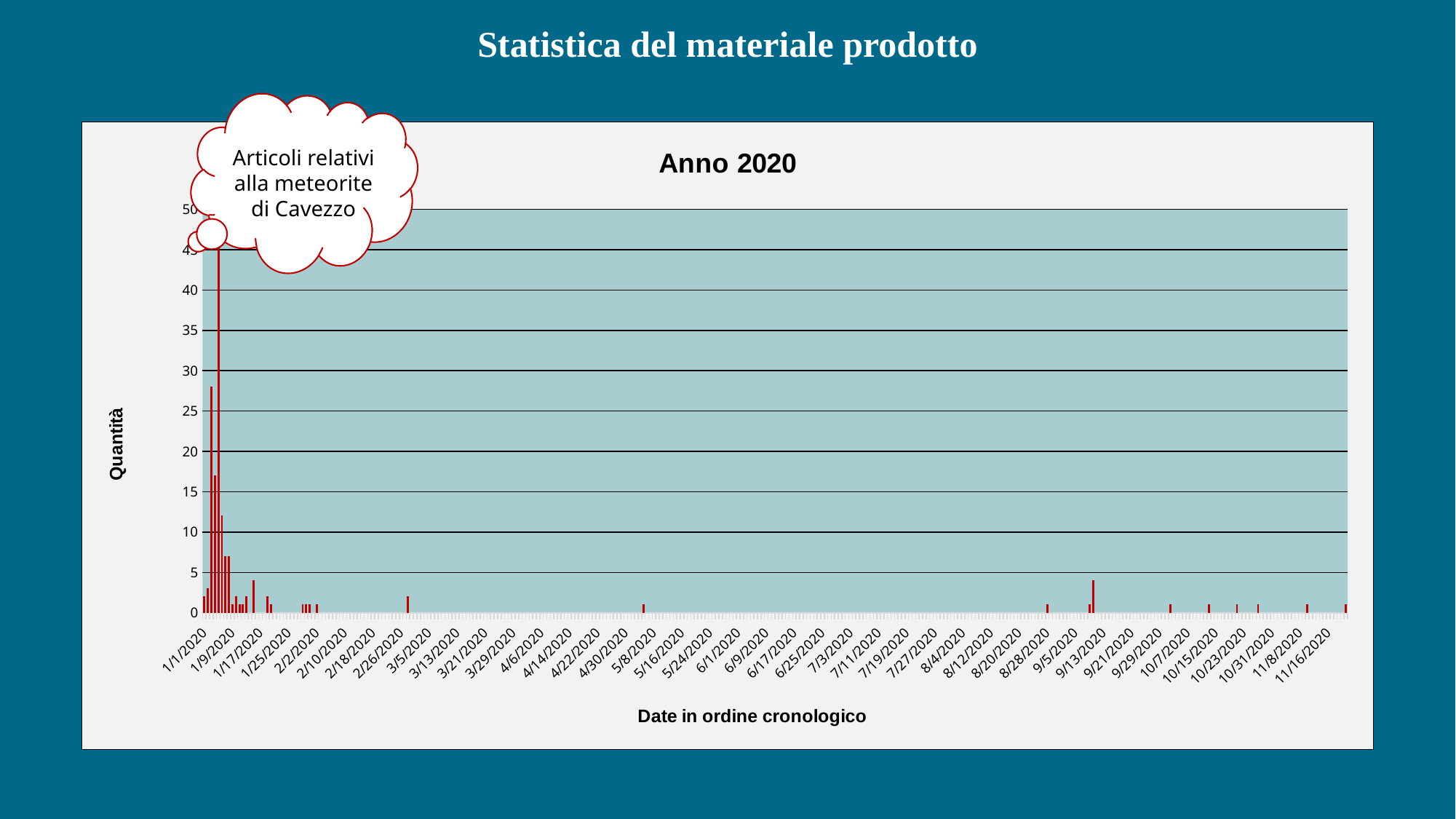
Do the values in the chart generally rise or fall along the x axis from January to November 2020? fall Is the value of the tallest bar in the chart greater or less than 40? greater What is the highest value shown on the vertical axis of the chart? 50 What is the label of the vertical axis of the chart? Quantità What kind of chart is shown on the slide? bar chart Is the value of the bar near 8/28/2020 greater or less than 5? less In which month of 2020 does the chart show its highest values? January What is the title of the chart? Anno 2020 Is the value of the bar near 5/8/2020 greater or less than 5? less Which is larger: the tallest bar in January 2020 or the bar near 9/13/2020? the tallest bar in January 2020